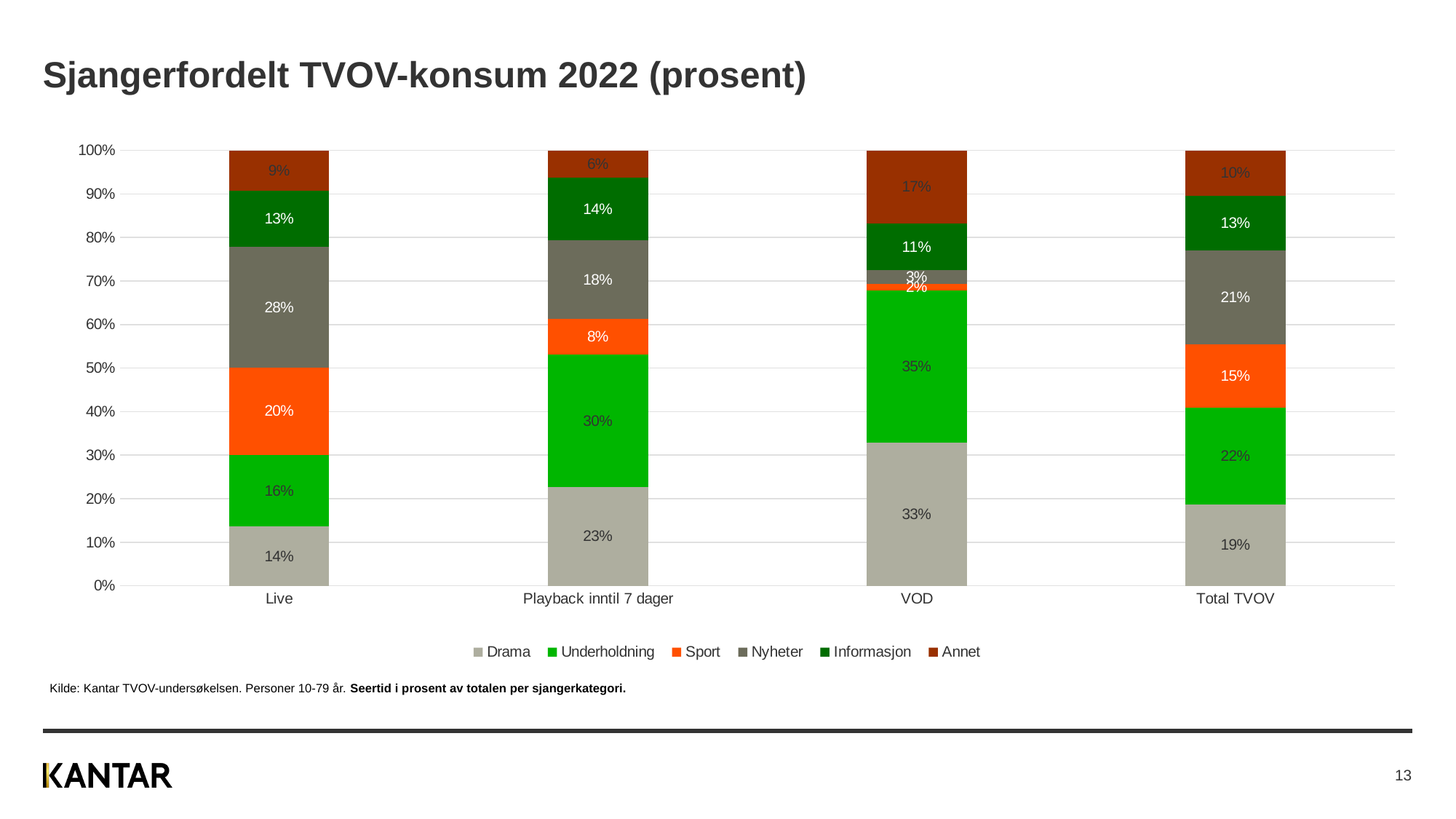
Which category has the highest Underholdning share? VOD Which is larger: the Drama share for Playback inntil 7 dager or for Total TVOV? Playback inntil 7 dager What is the Drama share for VOD? 33% What is the Nyheter share for Playback inntil 7 dager? 18% What is the difference between the Nyheter share for Live and for Total TVOV? 7% What is the Annet share for Total TVOV? 10% What is the title of the chart on the slide? Sjangerfordelt TVOV-konsum 2022 (prosent) Which category has the lowest Sport share? VOD How many series does the legend list? 6 What is the Sport share for Live? 20% How many categories are shown on the x axis? 4 What kind of chart is shown on the slide? Stacked bar chart